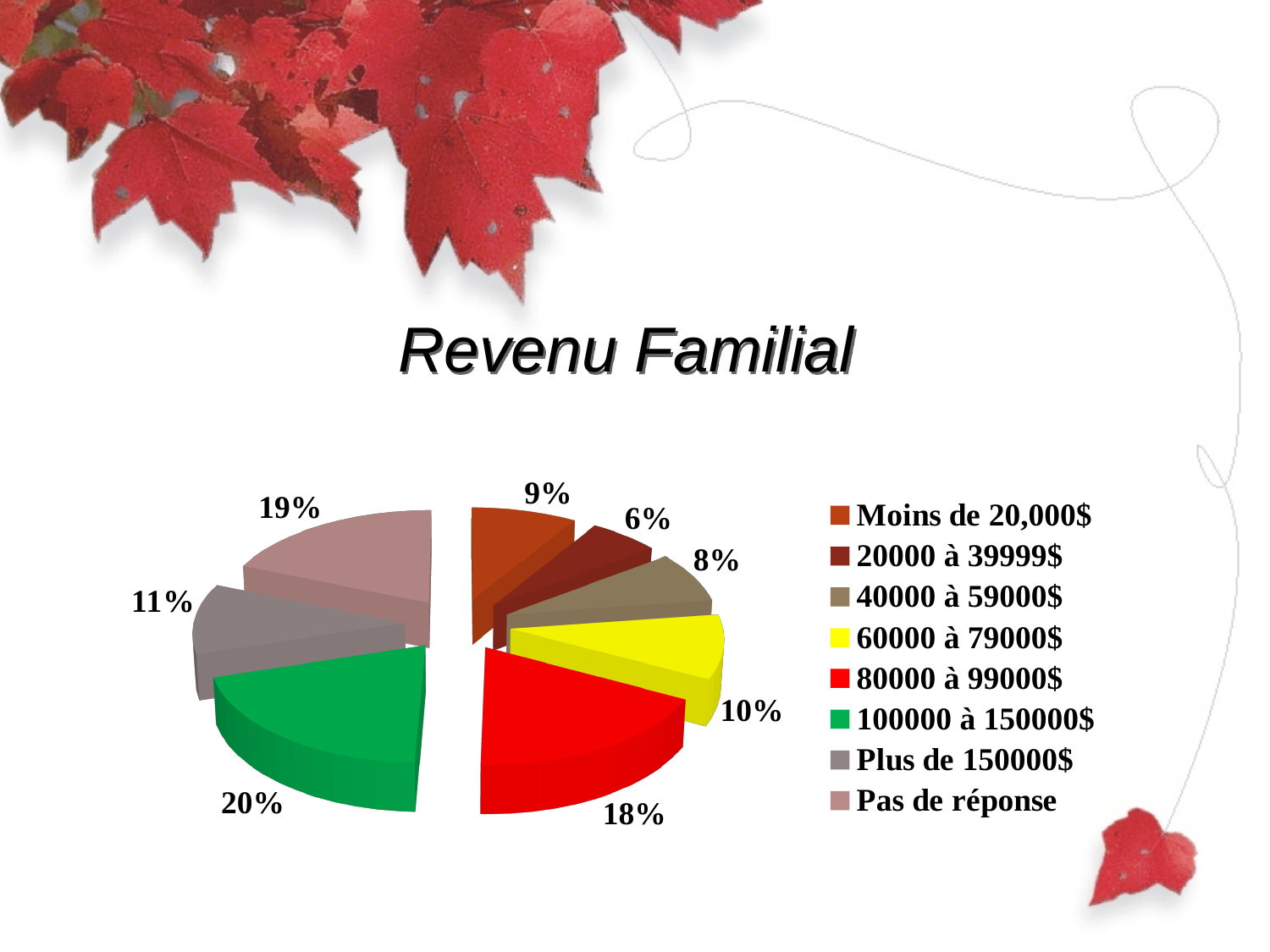
How many categories does the pie chart have? 8 Which category has the smallest slice of the pie? 20000 à 39999$ Which category has the largest slice of the pie? 100000 à 150000$ What percentage is shown for '20000 à 39999$'? 6% What percentage of the pie is the 'Moins de 20,000$' slice? 9% What kind of chart is shown on the slide? pie chart What colour is the slice for '60000 à 79000$'? yellow What is the difference in percentage points between '100000 à 150000$' and '60000 à 79000$'? 10 What is the title of the chart? Revenu Familial What percentage is shown for '80000 à 99000$'? 18% Which is larger, the slice for 'Plus de 150000$' or the slice for '40000 à 59000$'? Plus de 150000$ What percentage is shown for 'Pas de réponse'? 19%